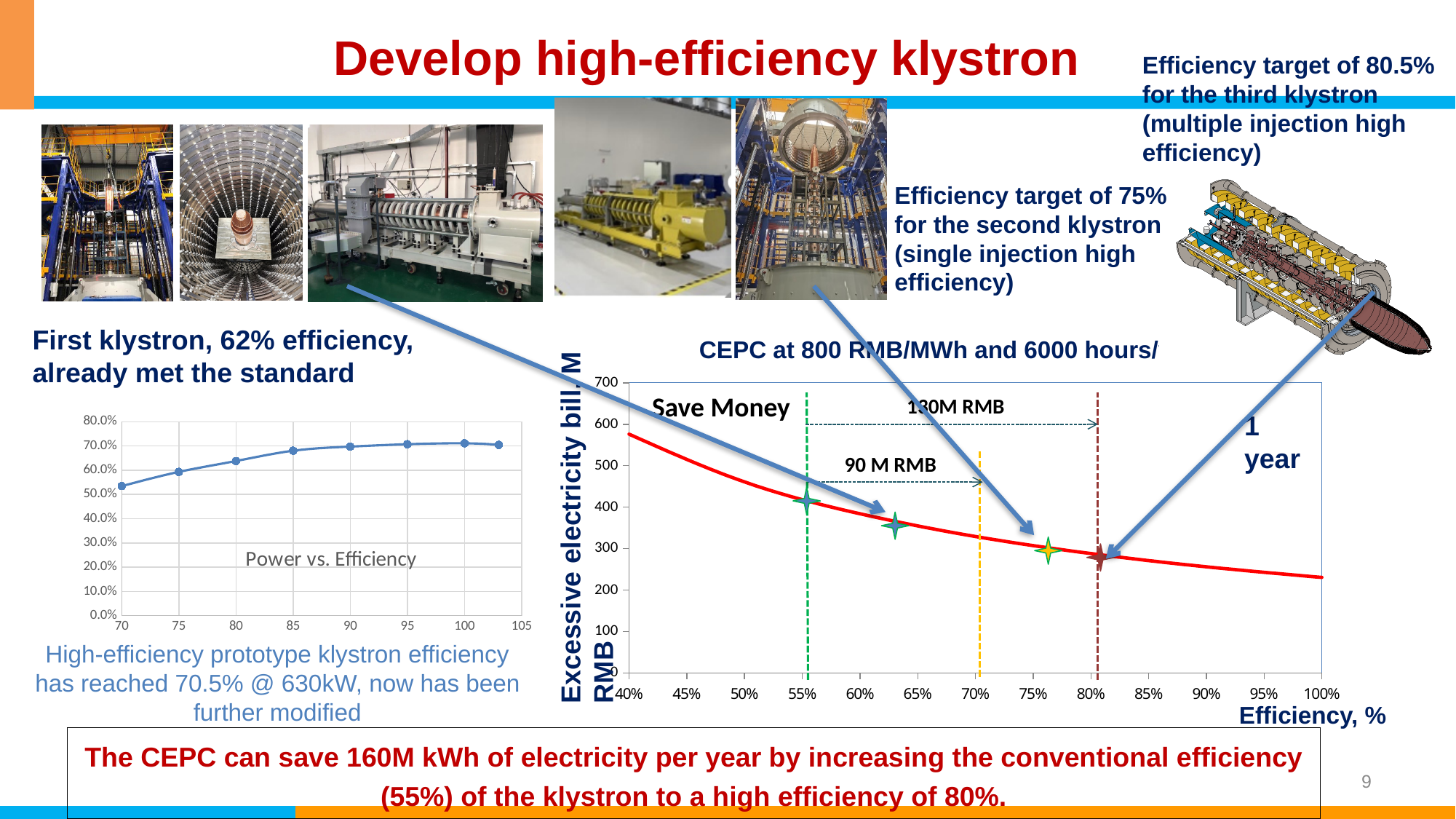
In the 'CEPC at 800 RMB/MWh and 6000 hours/' chart, does the red curve rise or fall as efficiency increases? fall In the 'Power vs. Efficiency' chart, at which x-axis value is the plotted efficiency lowest? 70 In the 'Power vs. Efficiency' chart, do the values generally rise or fall as the x-axis value increases from 70 to 100? rise In the 'Power vs. Efficiency' chart, which has the larger value: x = 75 or x = 85? 85 In the 'Power vs. Efficiency' chart, is the value at x = 70 greater or less than 60.0%? less How many data points are plotted in the 'Power vs. Efficiency' chart? 8 What is the y-axis label of the 'CEPC at 800 RMB/MWh and 6000 hours/' chart? Excessive electricity bill, M RMB In the 'CEPC at 800 RMB/MWh and 6000 hours/' chart, is the excessive electricity bill at 100% efficiency greater or less than 300? less What kind of chart is the 'Power vs. Efficiency' chart on the left? line chart What kind of chart is the 'CEPC at 800 RMB/MWh and 6000 hours/' chart on the right? line chart In the 'CEPC at 800 RMB/MWh and 6000 hours/' chart, is the excessive electricity bill at 55% efficiency greater or less than 400? greater